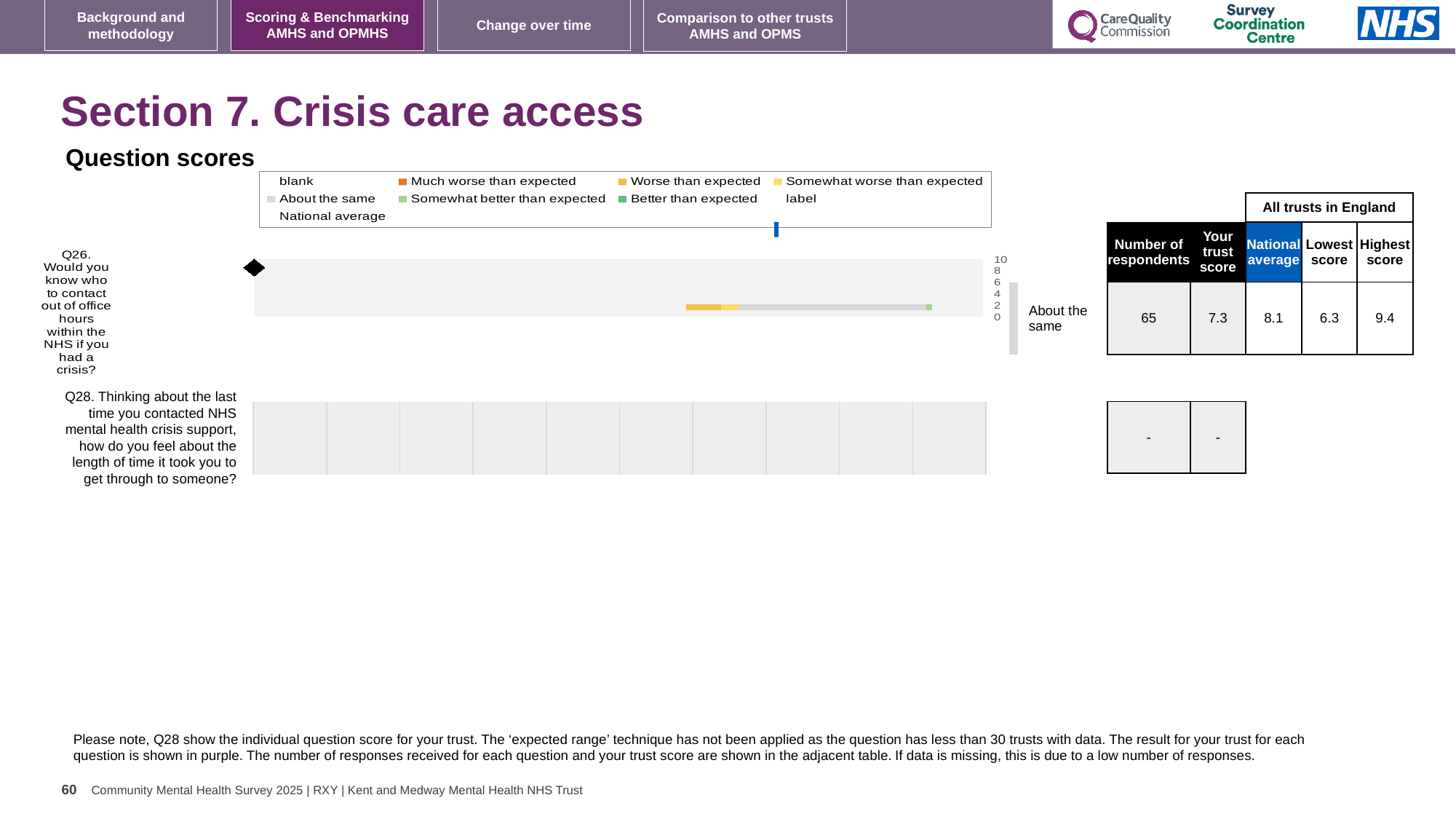
What colour represents 'Much worse than expected' in the chart legend? orange How many questions are plotted in the question scores chart? 2 What benchmark category label is shown for Q26 next to the chart? About the same What is the trust score for Q26 shown in the table next to the chart? 7.3 What is the difference between the highest and lowest scores for Q26 across all trusts in England? 3.1 What kind of chart is used to show the question scores on this slide? bar chart Which is larger for Q26, the trust score or the national average? national average What is the highest score among all trusts in England for Q26? 9.4 What is the lowest score among all trusts in England for Q26? 6.3 What is the national average for Q26 shown in the table next to the chart? 8.1 What is the difference between the national average and the trust score for Q26? 0.8 How many respondents answered Q26 according to the table next to the chart? 65